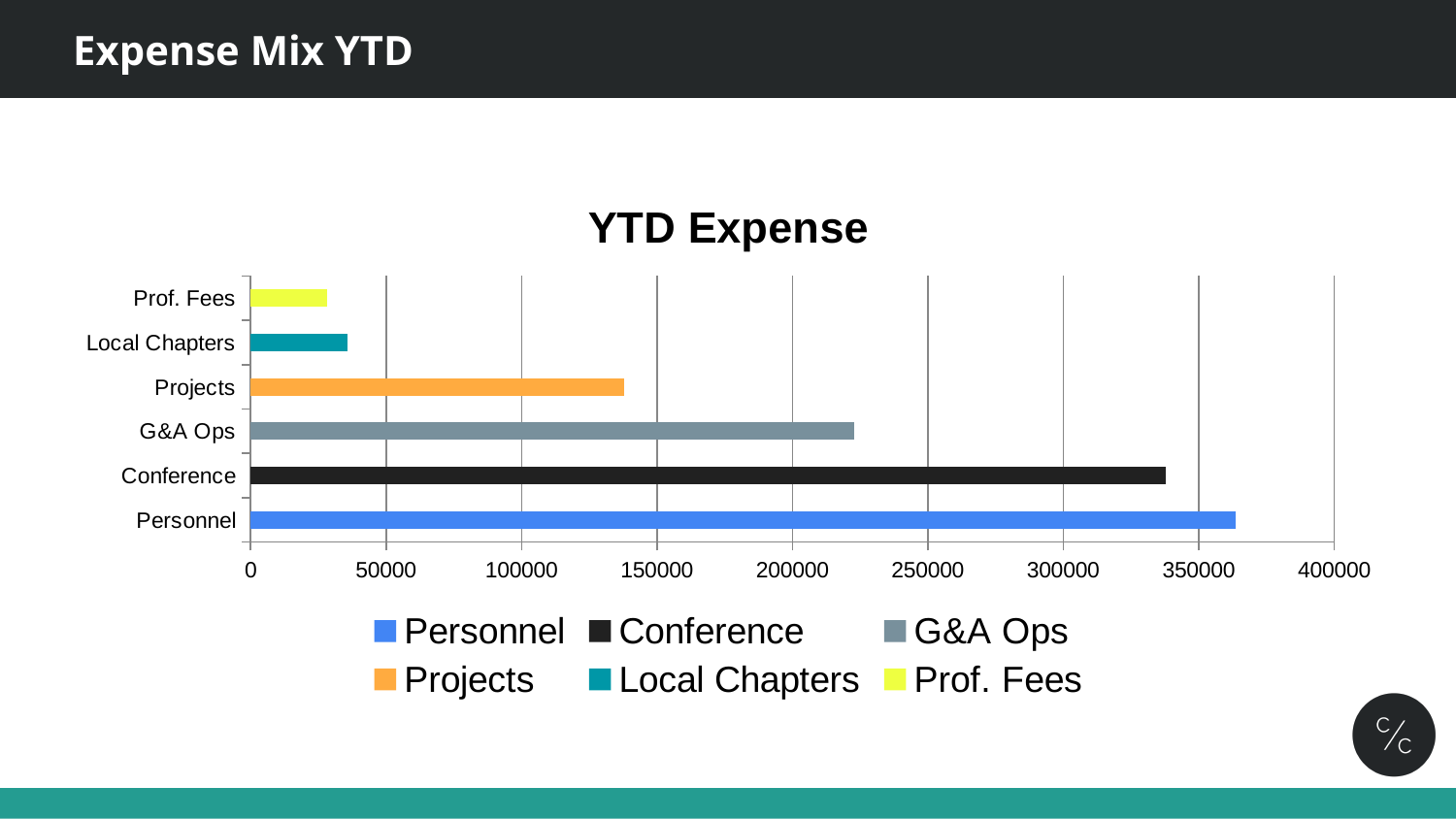
Is the value for G&A Ops greater or less than 200000? greater Is the value for Conference greater or less than 300000? greater Is the value for Personnel greater or less than 350000? greater Which is larger, the value for G&A Ops or the value for Projects? G&A Ops Which category has the lowest YTD expense? Prof. Fees What kind of chart is shown on the slide? bar chart How many categories are plotted in the chart? 6 What is the title of the chart? YTD Expense Which category has the highest YTD expense? Personnel Which is larger, the value for Local Chapters or the value for Prof. Fees? Local Chapters How many entries does the legend list? 6